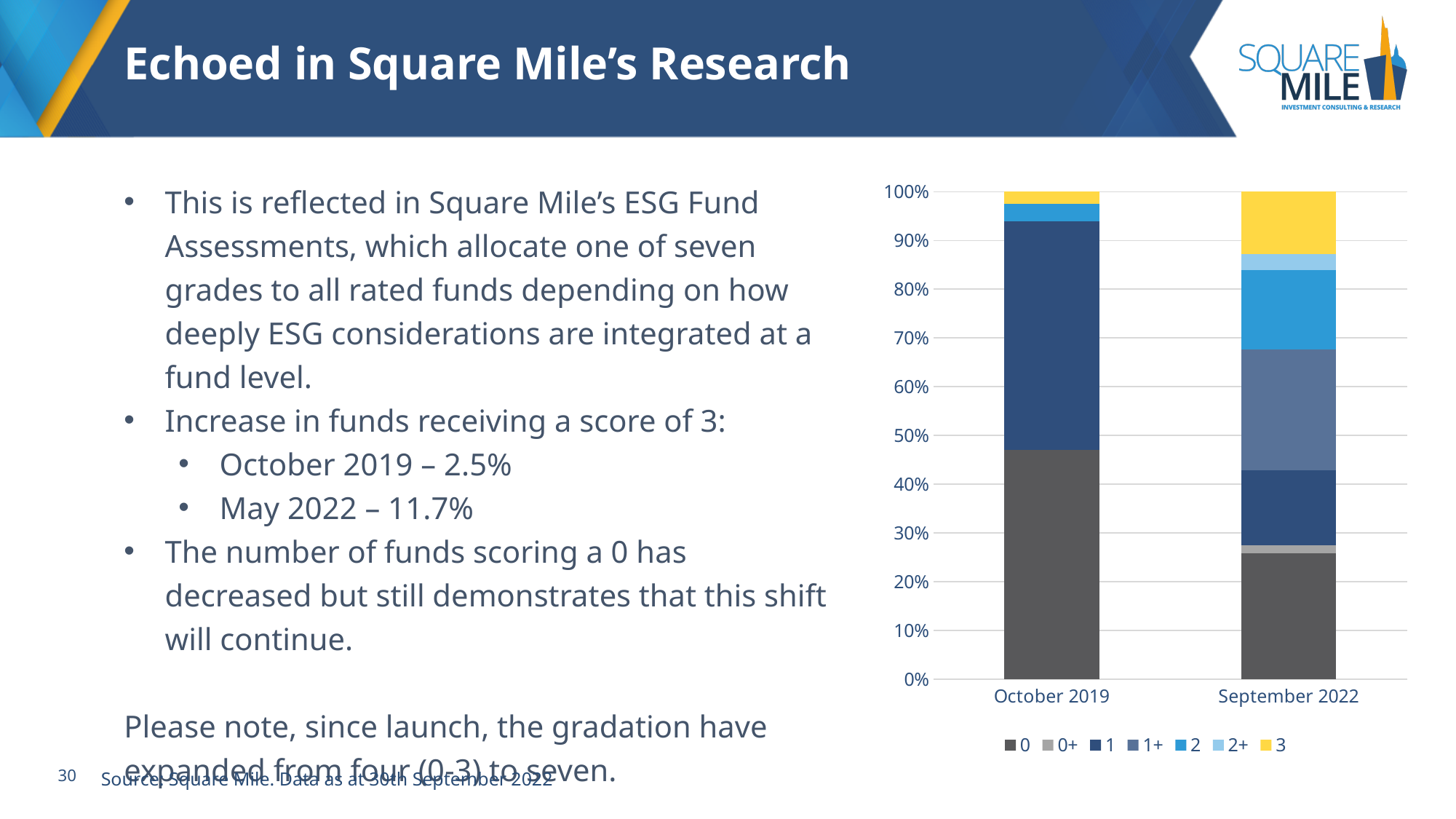
Is the share for grade 0 in September 2022 greater or less than 30%? less Which colour represents grade 3 in the chart's legend? Yellow Which category has the larger share for grade 0, October 2019 or September 2022? October 2019 Which category has the larger share for grade 3, October 2019 or September 2022? September 2022 Does the share for grade 0 rise or fall from October 2019 to September 2022? fall Is the share for grade 0 in September 2022 greater or less than 20%? greater What kind of chart is shown on the slide? Stacked bar chart How many series does the chart's legend list? 7 Is the share for grade 0 in October 2019 greater or less than 50%? less What does each stacked bar in the chart total? 100% What are the two categories on the x axis of the chart? October 2019 and September 2022 How many categories are shown on the x axis of the chart? 2